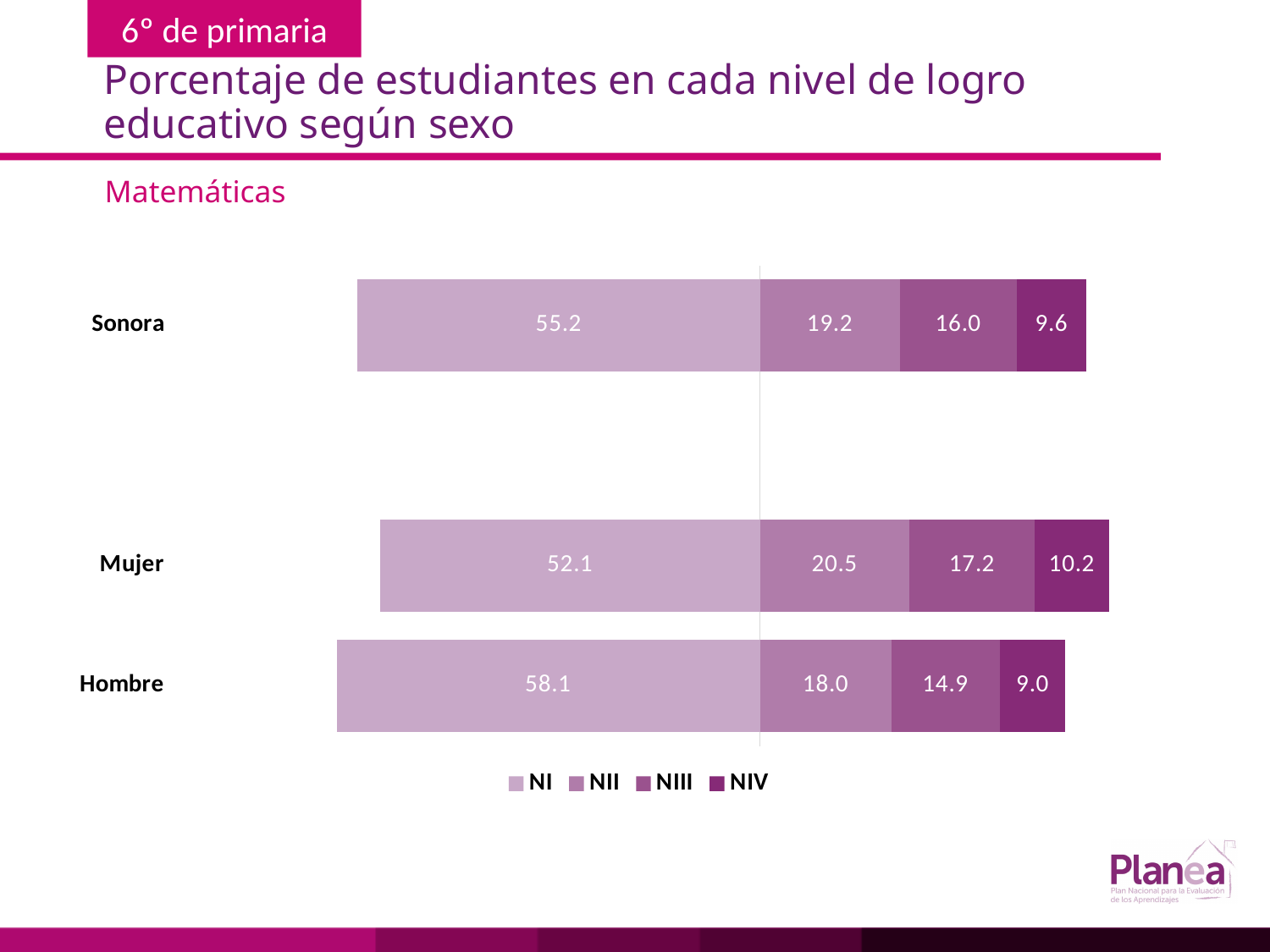
What type of chart is shown on the slide? Stacked bar chart Which category has the lowest NIV value? Hombre What is the NII value for Sonora? 19.2 What is the difference between the NI values for Hombre and Mujer? 6.0 Which is larger, the NIII value for Mujer or the NIII value for Sonora? Mujer How many categories are shown in the chart? 3 What is the NI value for Hombre? 58.1 How many series does the legend list? 4 What is the NIII value for Hombre? 14.9 What is the NIV value for Mujer? 10.2 Which category has the highest NI value? Hombre What is the total of the stacked bar for Sonora? 100.0